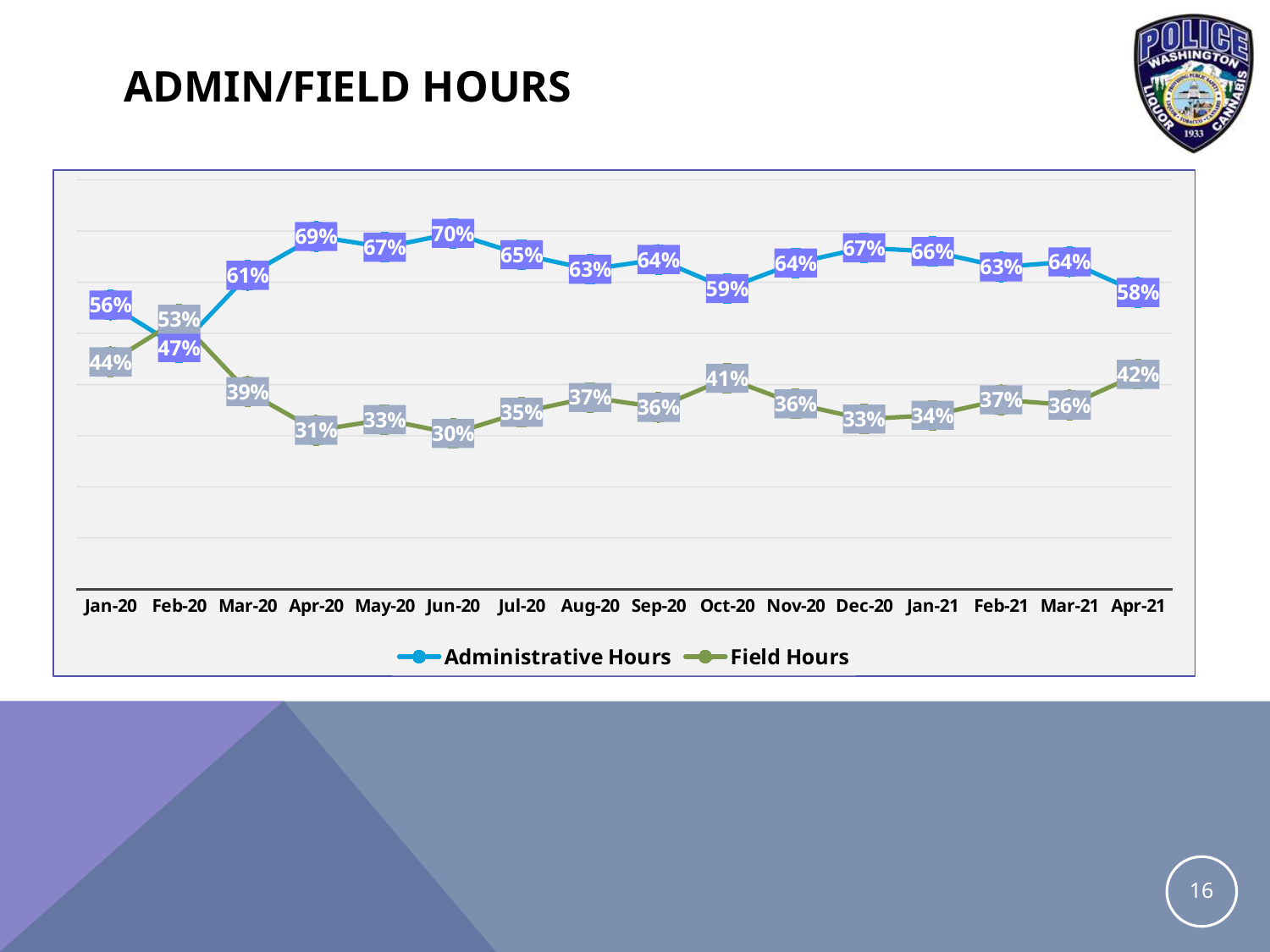
What is the difference between Administrative Hours and Field Hours in Apr-20? 38% How many months are shown on the x axis? 16 How many series does the legend list? 2 What kind of chart is shown on the slide? Line chart What is the Administrative Hours value for Apr-21? 58% In which month is Administrative Hours at its highest? Jun-20 In which month is Field Hours at its highest? Feb-20 What is the Field Hours value for Oct-20? 41% What is the title of the slide containing the chart? ADMIN/FIELD HOURS What is the Administrative Hours value for Jun-20? 70% In which month is Field Hours at its lowest? Jun-20 Which is larger in Feb-20, Administrative Hours or Field Hours? Field Hours